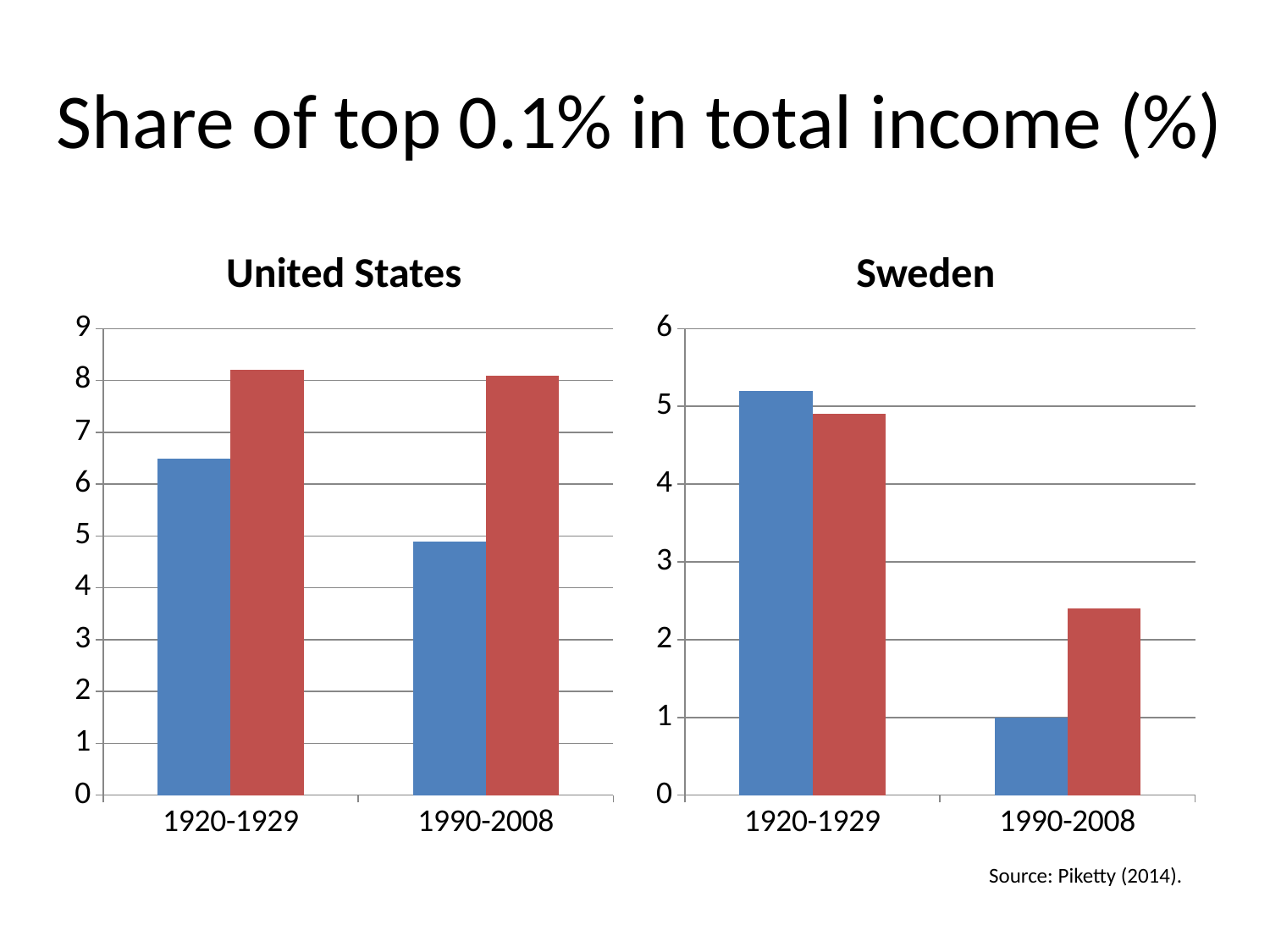
In the United States chart, which is larger for 1920-1929, the blue bar or the red bar? the red bar In the United States chart, is the blue bar for 1920-1929 greater or less than 6? greater In the Sweden chart, is the red bar for 1990-2008 greater or less than 2? greater In the Sweden chart, do the blue bars rise or fall from 1920-1929 to 1990-2008? fall In the Sweden chart, which is larger for 1990-2008, the blue bar or the red bar? the red bar What is the highest value shown on the y axis of the Sweden chart? 6 In the Sweden chart, is the blue bar for 1920-1929 greater or less than 5? greater What is the title of the slide? Share of top 0.1% in total income (%) How many categories are shown on the x axis of the Sweden chart? 2 What kind of chart is the United States chart? bar chart